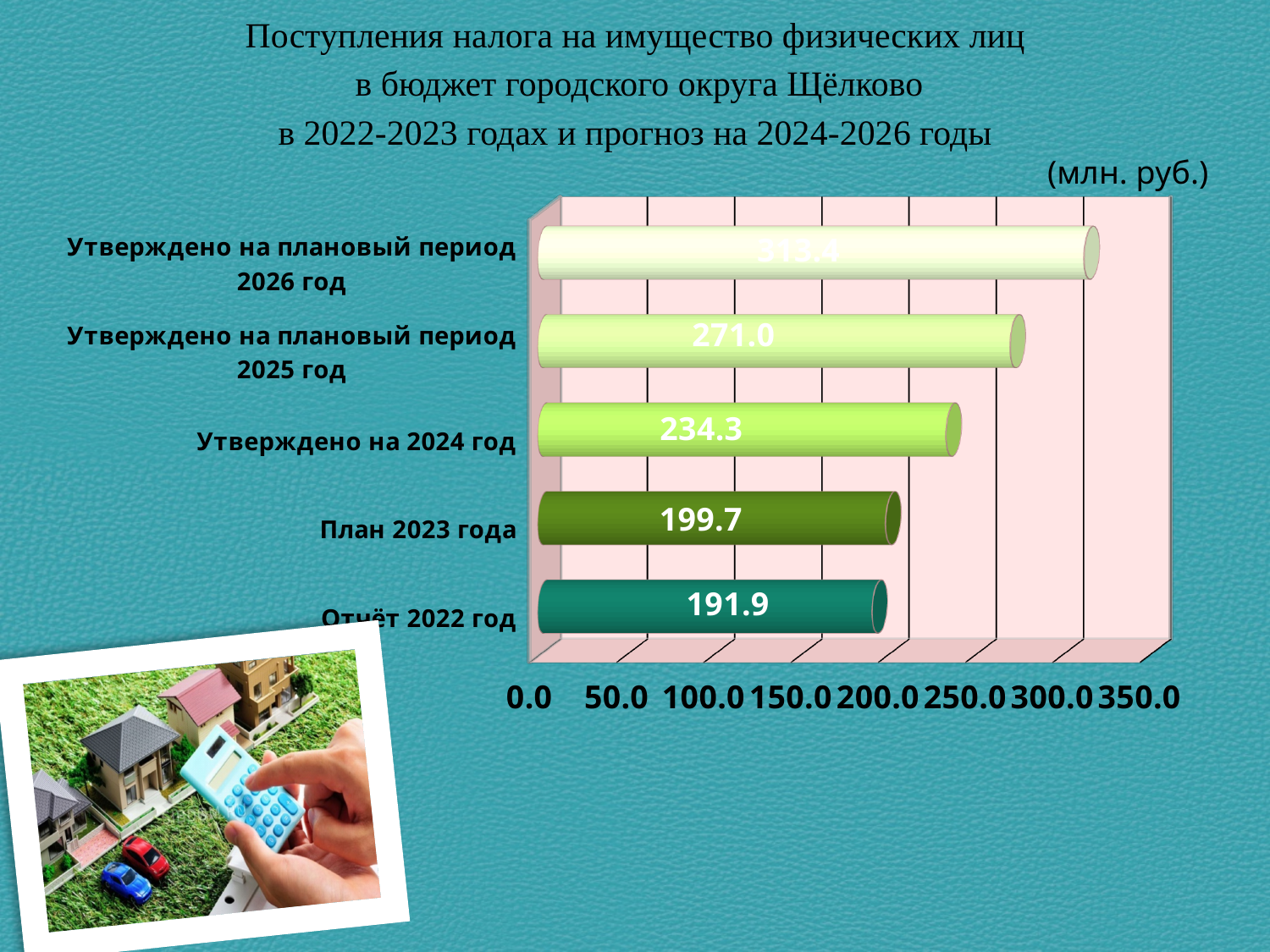
Is the value for "Утверждено на плановый период 2026 год" greater or less than 300.0? greater What is the value for "Отчёт 2022 год"? 191.9 What is the difference between the values for "План 2023 года" and "Отчёт 2022 год"? 7.8 What is the value for "Утверждено на 2024 год"? 234.3 What is the value for "Утверждено на плановый период 2025 год"? 271.0 What is the value for "План 2023 года"? 199.7 Which is larger: the value for "Утверждено на плановый период 2025 год" or the value for "Утверждено на 2024 год"? Утверждено на плановый период 2025 год Which category has the highest value? Утверждено на плановый период 2026 год How many categories are shown in the chart? 5 What type of chart is shown on the slide? bar chart What is the difference between the values for "Утверждено на 2024 год" and "План 2023 года"? 34.6 Which category has the lowest value? Отчёт 2022 год